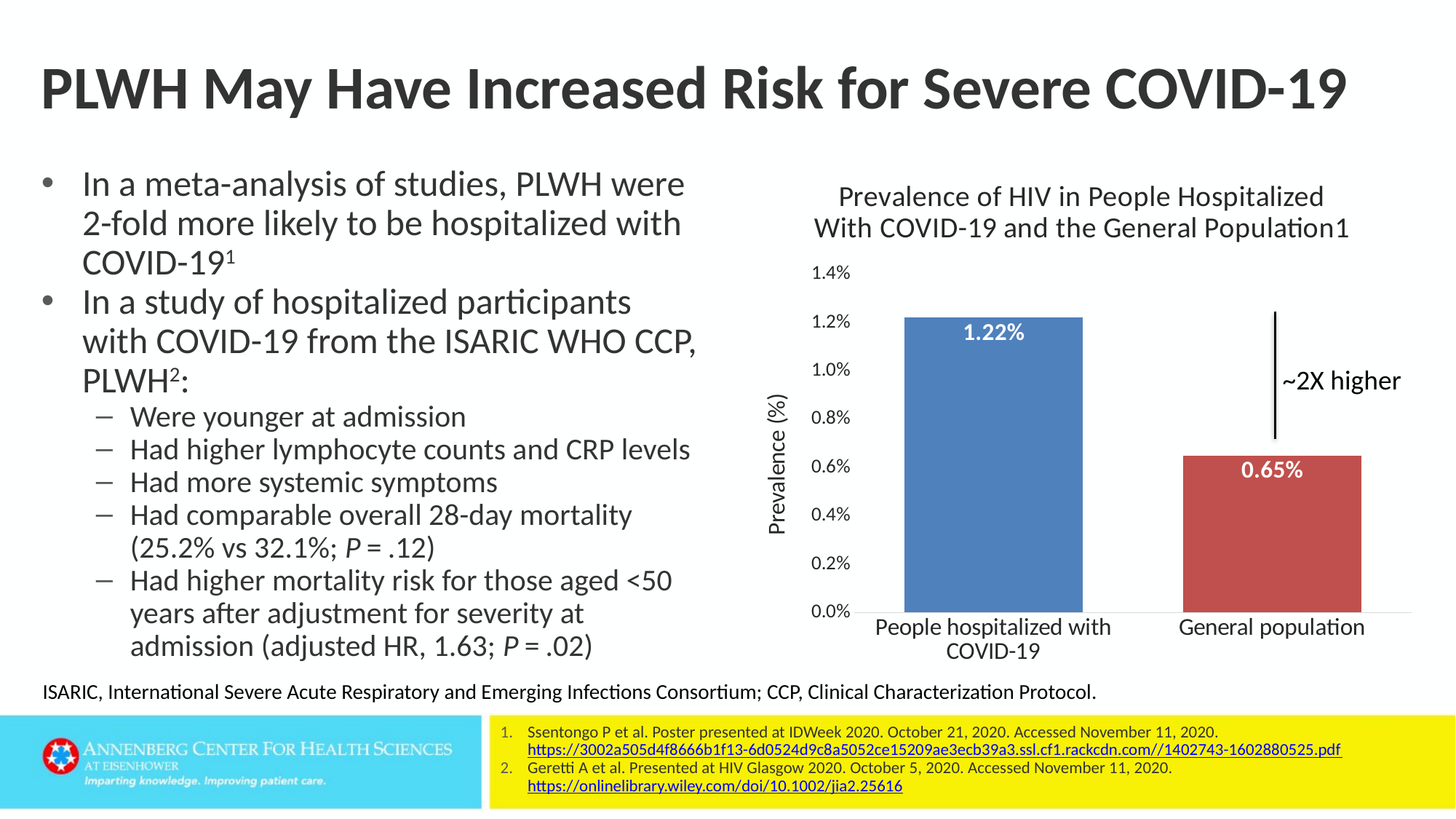
Which category has the lower HIV prevalence? General population What is the difference in HIV prevalence between people hospitalized with COVID-19 and the general population? 0.57% What type of chart is shown on the slide? Bar chart Which category has the higher HIV prevalence? People hospitalized with COVID-19 Is the HIV prevalence higher for people hospitalized with COVID-19 or for the general population? People hospitalized with COVID-19 What annotation is shown between the two bars in the chart? ~2X higher Is the HIV prevalence for people hospitalized with COVID-19 greater or less than 1.0%? greater Is the HIV prevalence for the general population greater or less than 1.0%? less What is the prevalence of HIV in the general population according to the chart? 0.65% What is the label of the y-axis of the chart? Prevalence (%) How many categories are shown in the chart? 2 What is the prevalence of HIV among people hospitalized with COVID-19? 1.22%